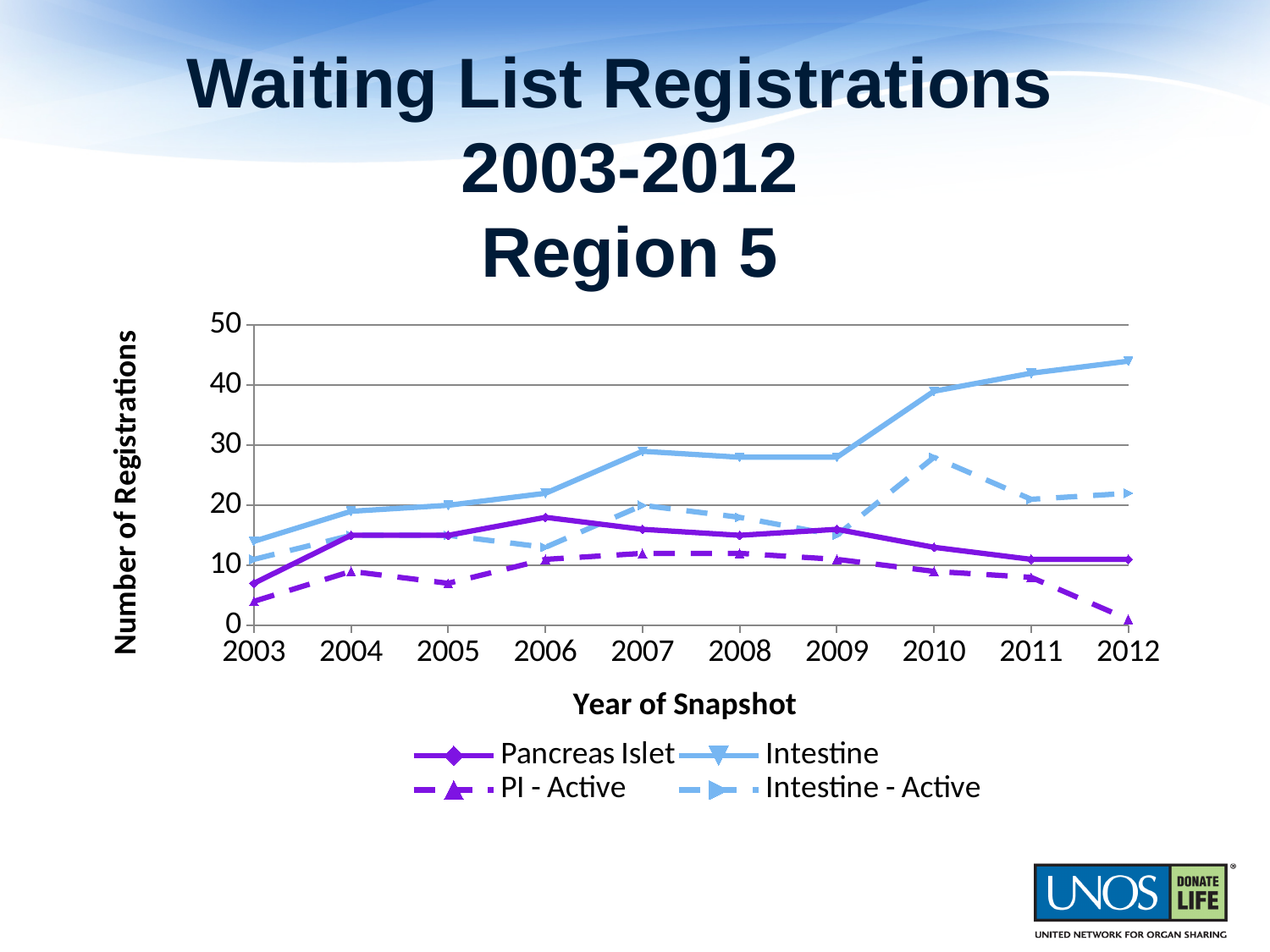
Is the value for Intestine - Active in 2010 greater or less than 20? greater Is the value for Intestine in 2012 greater or less than 40? greater How many years are plotted along the x axis? 10 What is the title of the x axis? Year of Snapshot Is the value for PI - Active in 2012 greater or less than 10? less In which year does the Intestine series reach its highest value? 2012 What kind of chart is shown on the slide? Line chart In 2012, which is larger: Intestine or Pancreas Islet? Intestine How many series does the legend list? 4 In which year does the PI - Active series reach its lowest value? 2012 Does the Intestine series generally rise or fall from 2003 to 2012? Rise